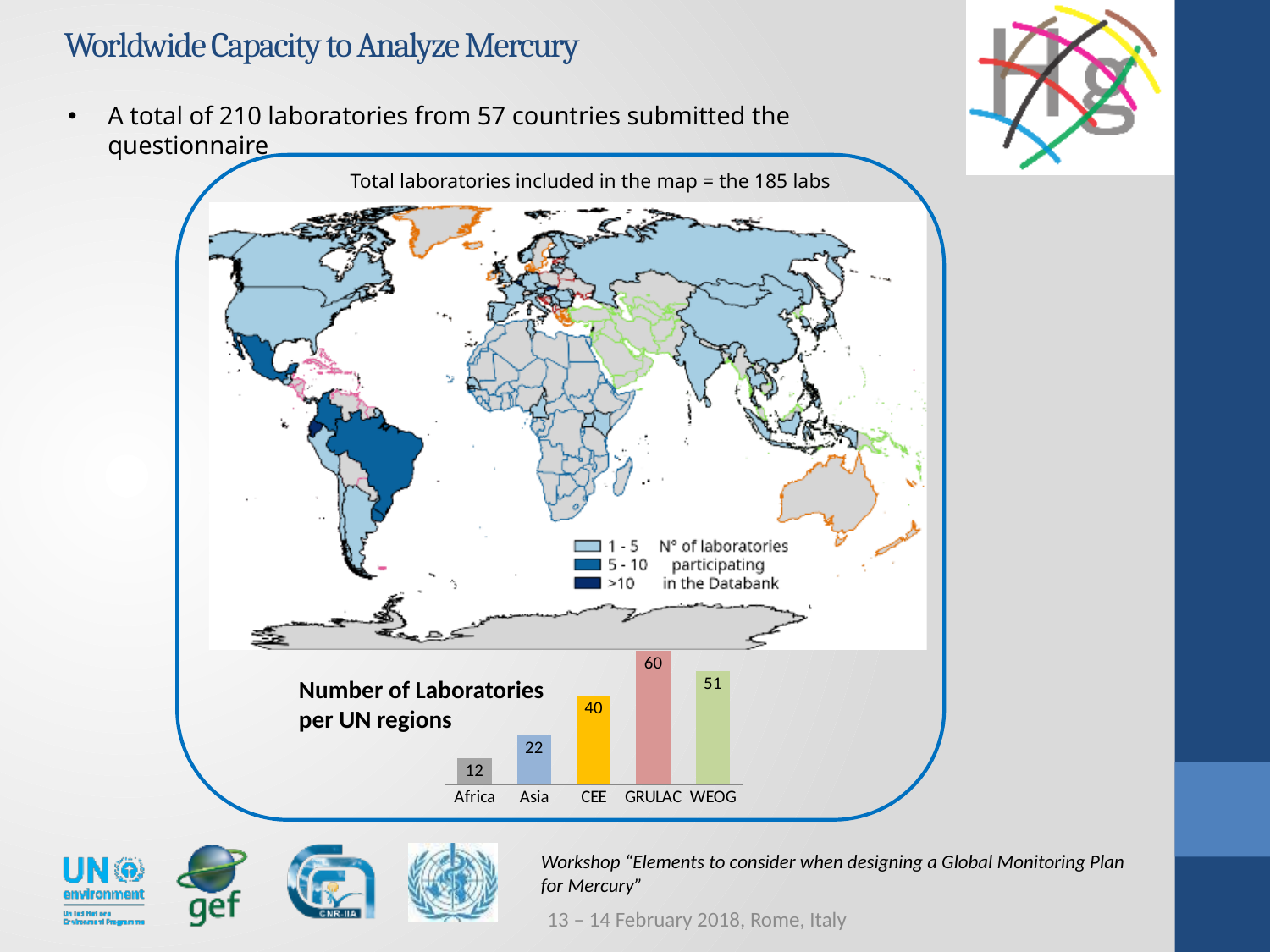
In the 'Number of Laboratories per UN regions' chart, how many laboratories are in Africa? 12 In the 'Number of Laboratories per UN regions' chart, what is the difference between the values for GRULAC and WEOG? 9 In the 'Number of Laboratories per UN regions' chart, what is the value for GRULAC? 60 What kind of chart is the 'Number of Laboratories per UN regions' chart? Bar chart In the 'Number of Laboratories per UN regions' chart, which UN region has the lowest number of laboratories? Africa In the 'Number of Laboratories per UN regions' chart, what is the difference between the values for CEE and Asia? 18 In the 'Number of Laboratories per UN regions' chart, which has more laboratories, CEE or WEOG? WEOG In the 'Number of Laboratories per UN regions' chart, how many laboratories are in Asia? 22 How many UN regions are shown in the 'Number of Laboratories per UN regions' chart? 5 In the 'Number of Laboratories per UN regions' chart, what is the value for WEOG? 51 In the 'Number of Laboratories per UN regions' chart, which UN region has the highest number of laboratories? GRULAC In the 'Number of Laboratories per UN regions' chart, what is the value for CEE? 40